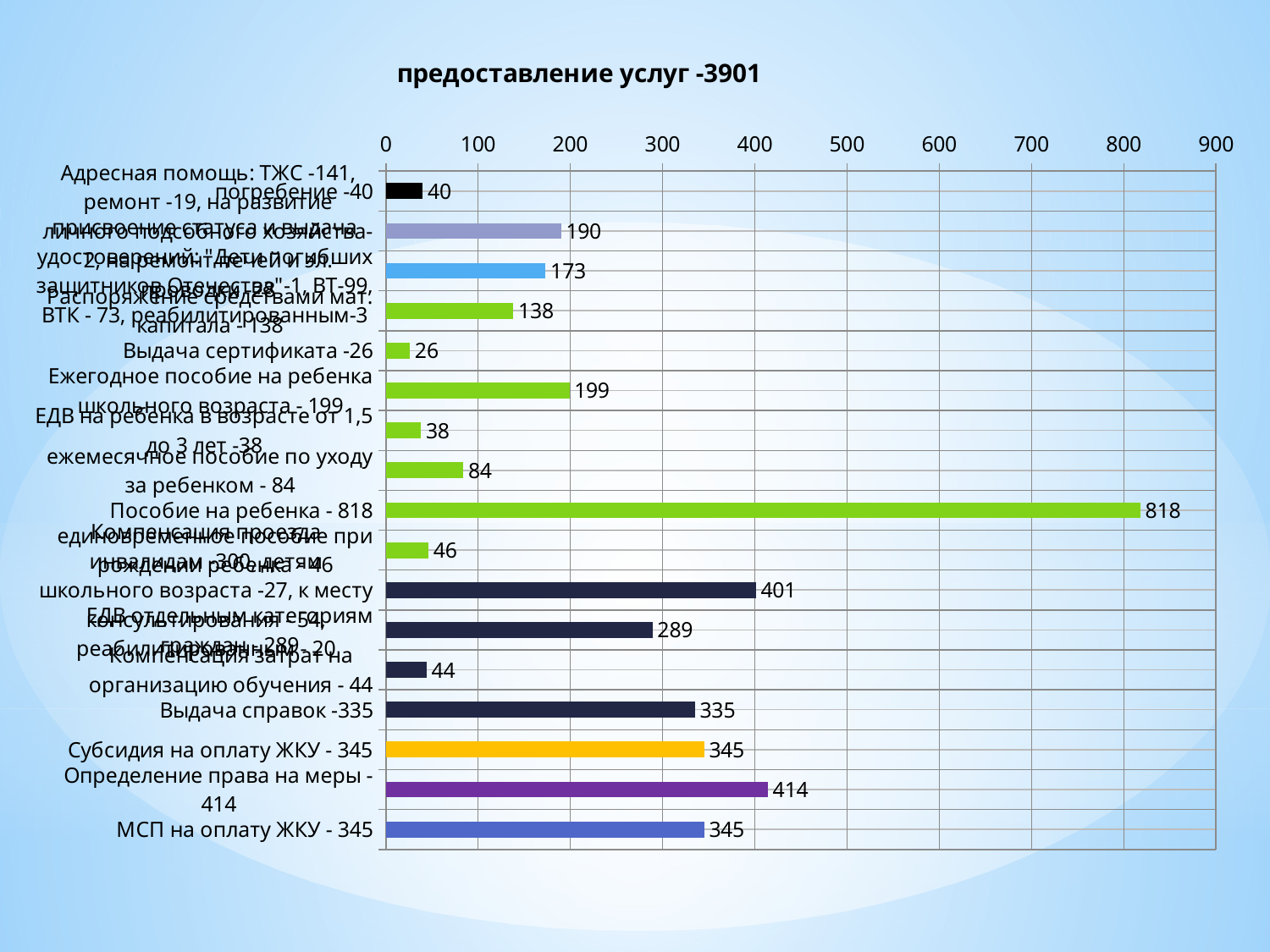
Which category has the highest value? Пособие на ребенка - 818 Is the value for 'Пособие на ребенка' greater or less than 800? greater How many bars are plotted in the chart? 17 What is the value for 'Определение права на меры'? 414 What is the value for 'ежемесячное пособие по уходу за ребенком'? 84 What is the value for 'Выдача справок'? 335 What is the difference between the values for 'Ежегодное пособие на ребенка школьного возраста' and 'ЕДВ на ребенка в возрасте от 1,5 до 3 лет'? 161 What is the difference between the values for 'Определение права на меры' and 'Субсидия на оплату ЖКУ'? 69 Which is larger: the value for 'Выдача справок' or the value for 'МСП на оплату ЖКУ'? МСП на оплату ЖКУ What is the title of the chart? предоставление услуг -3901 Which category has the lowest value? Выдача сертификата -26 What kind of chart is shown on the slide? bar chart